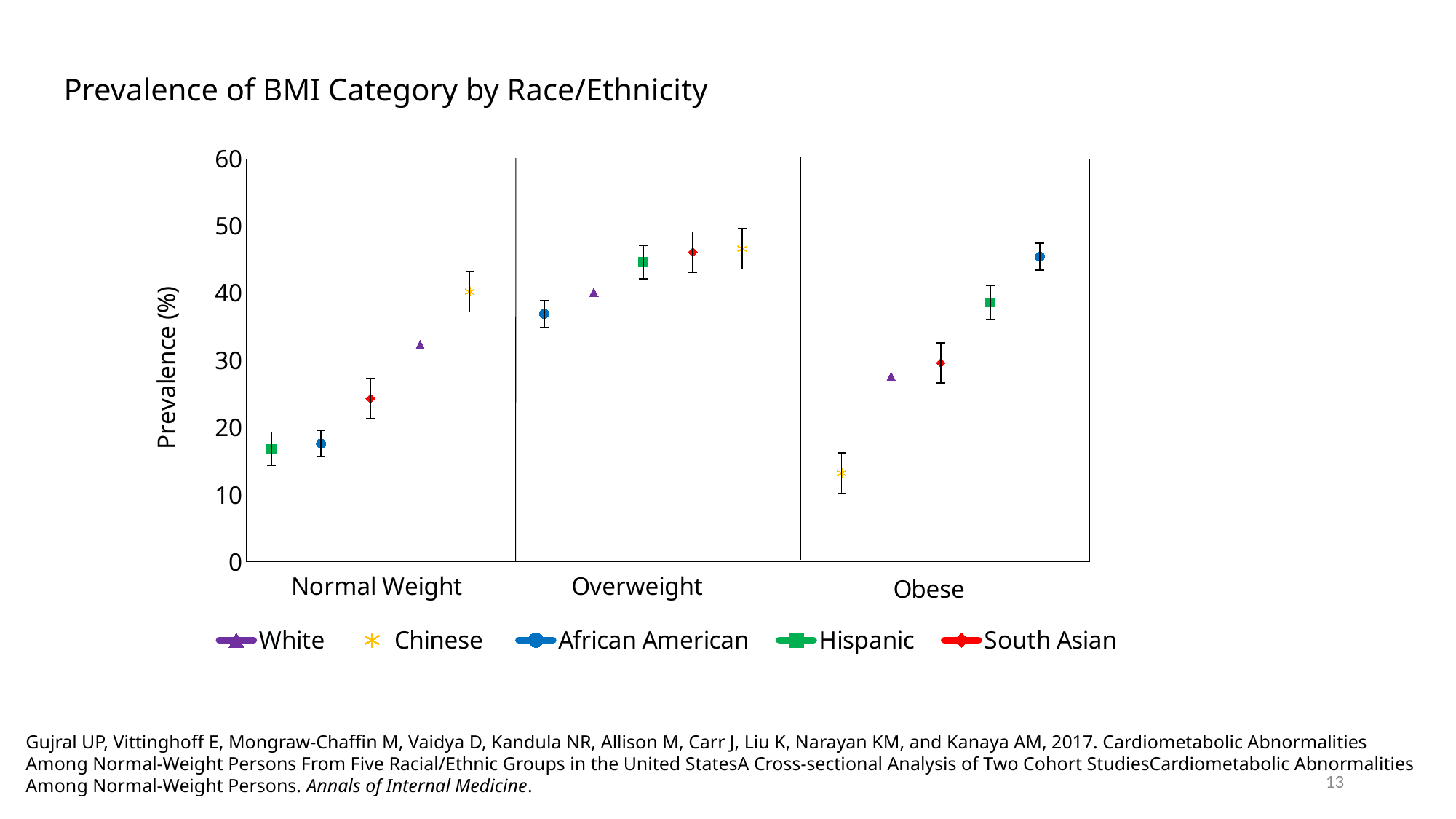
Is the prevalence for African American in the Obese category greater or less than 40? greater What is the title of the chart? Prevalence of BMI Category by Race/Ethnicity Is the prevalence for Chinese in the Obese category greater or less than 20? less How many BMI categories are shown on the x axis? 3 For the Chinese group, is prevalence higher in the Normal Weight category or the Obese category? Normal Weight In the Overweight category, which race/ethnicity group has the lowest prevalence? African American Is the prevalence for Hispanic in the Normal Weight category greater or less than 20? less In the Obese category, which race/ethnicity group has the highest prevalence? African American In the Obese category, which race/ethnicity group has the lowest prevalence? Chinese How many series does the legend list? 5 What is the label of the y axis? Prevalence (%) In the Normal Weight category, which race/ethnicity group has the highest prevalence? Chinese